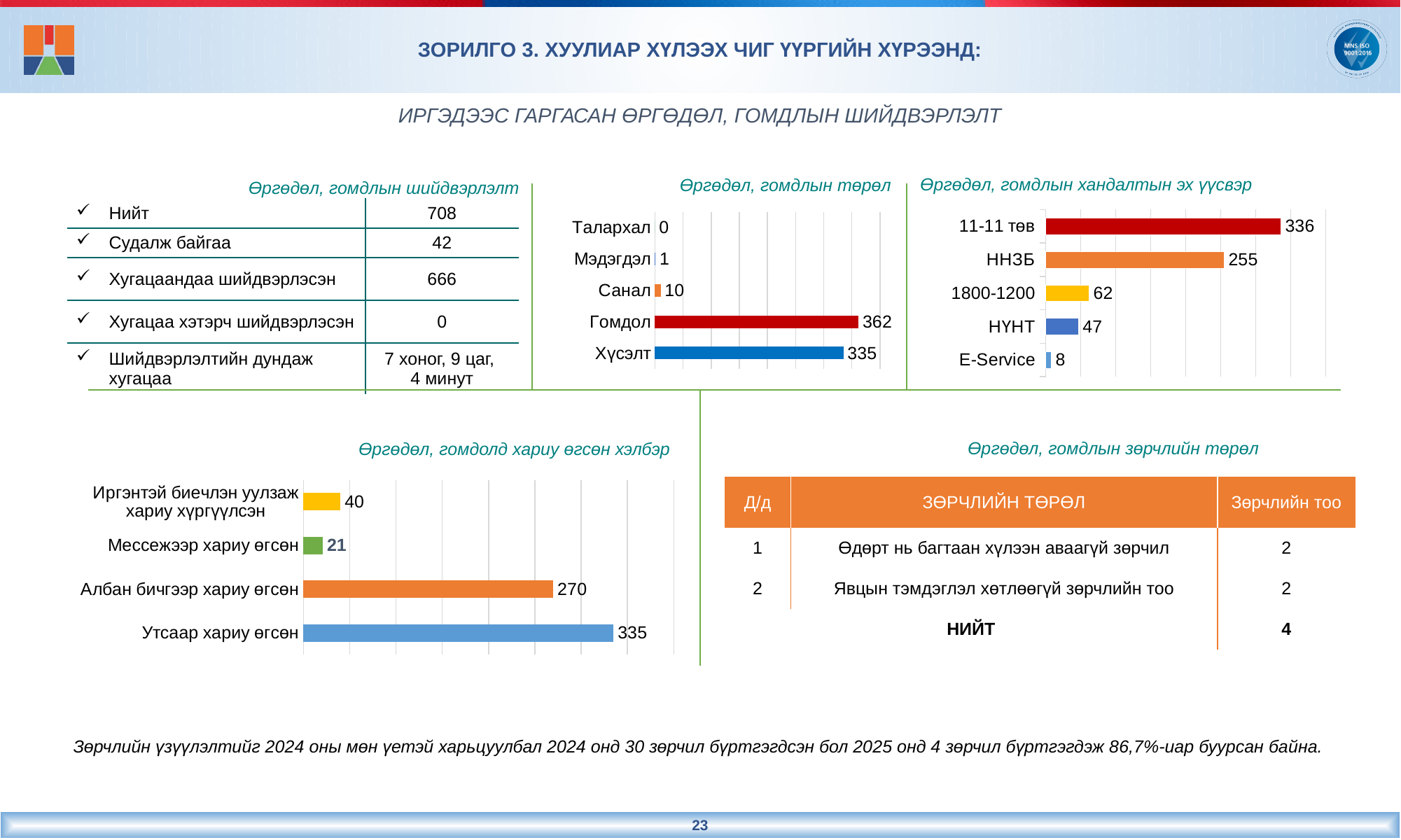
In the chart titled "Өргөдөл, гомдлын төрөл", what is the value for Гомдол? 362 In the chart titled "Өргөдөл, гомдлын төрөл", how many categories are plotted? 5 In the chart titled "Өргөдөл, гомдлын төрөл", which category has the lowest value? Талархал In the chart titled "Өргөдөл, гомдлын хандалтын эх үүсвэр", which category has the lowest value? E-Service What type of chart is the one titled "Өргөдөл, гомдолд хариу өгсөн хэлбэр"? Bar chart In the chart titled "Өргөдөл, гомдлын хандалтын эх үүсвэр", which is larger, the value for 1800-1200 or the value for НҮНТ? 1800-1200 In the chart titled "Өргөдөл, гомдолд хариу өгсөн хэлбэр", what is the value for Албан бичгээр хариу өгсөн? 270 In the chart titled "Өргөдөл, гомдлын төрөл", which category has the highest value? Гомдол In the chart titled "Өргөдөл, гомдлын төрөл", what is the difference between the values for Гомдол and Хүсэлт? 27 In the chart titled "Өргөдөл, гомдлын хандалтын эх үүсвэр", which category has the highest value? 11-11 төв In the chart titled "Өргөдөл, гомдлын хандалтын эх үүсвэр", what is the value for ННЗБ? 255 In the chart titled "Өргөдөл, гомдолд хариу өгсөн хэлбэр", what is the difference between the values for Утсаар хариу өгсөн and Мессежээр хариу өгсөн? 314